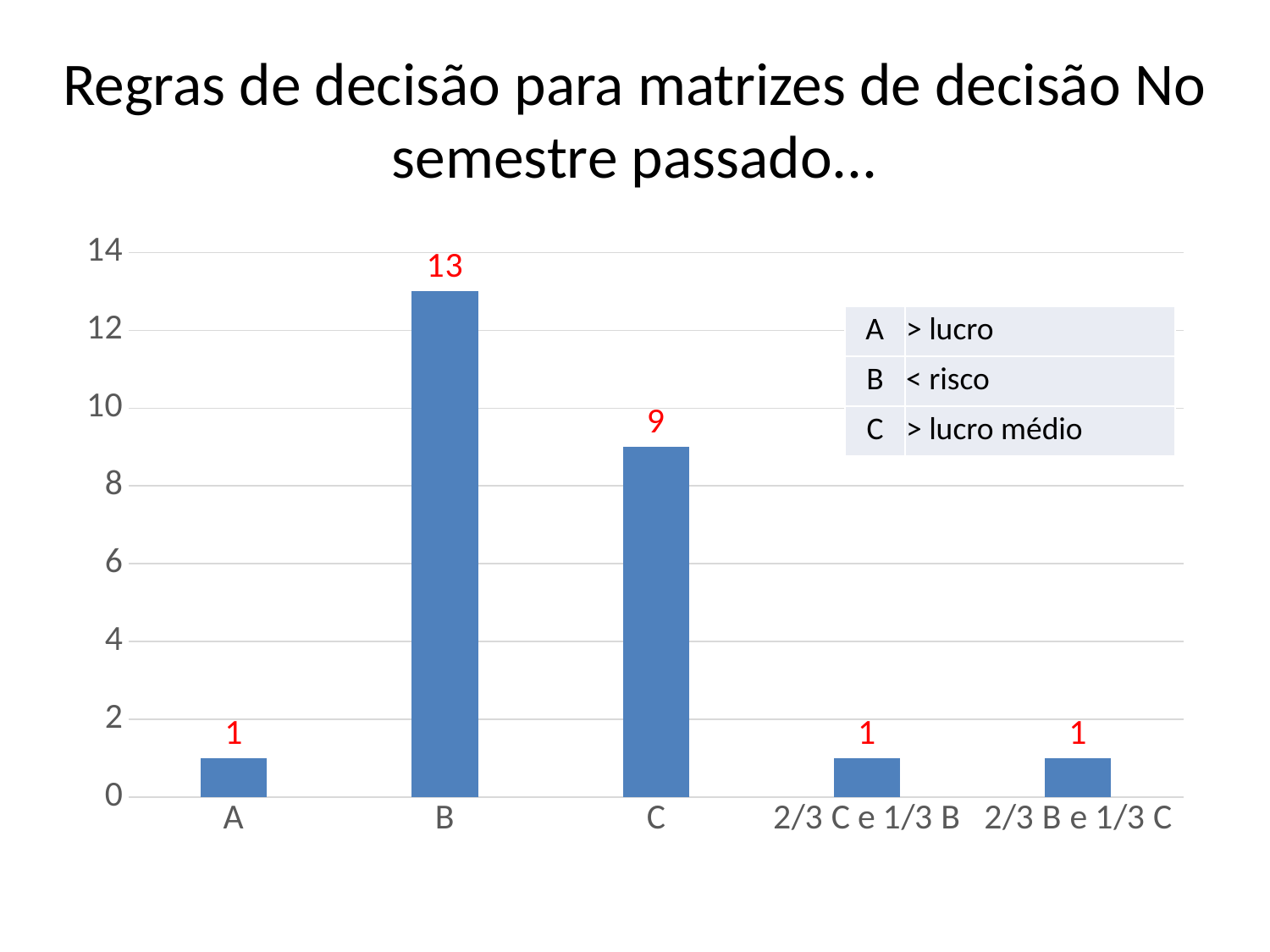
What is the value for category A? 1 What kind of chart is shown on the slide? bar chart What is the difference between the values for B and C? 4 What is the difference between the values for B and A? 12 Which category has the highest value? B What is the value for the category '2/3 C e 1/3 B'? 1 Is the value for C greater or less than 10? less According to the table on the slide, what does B stand for? < risco How many categories are shown on the x axis? 5 What is the value for category B? 13 Which is larger, the value for B or the value for C? B What is the value for category C? 9